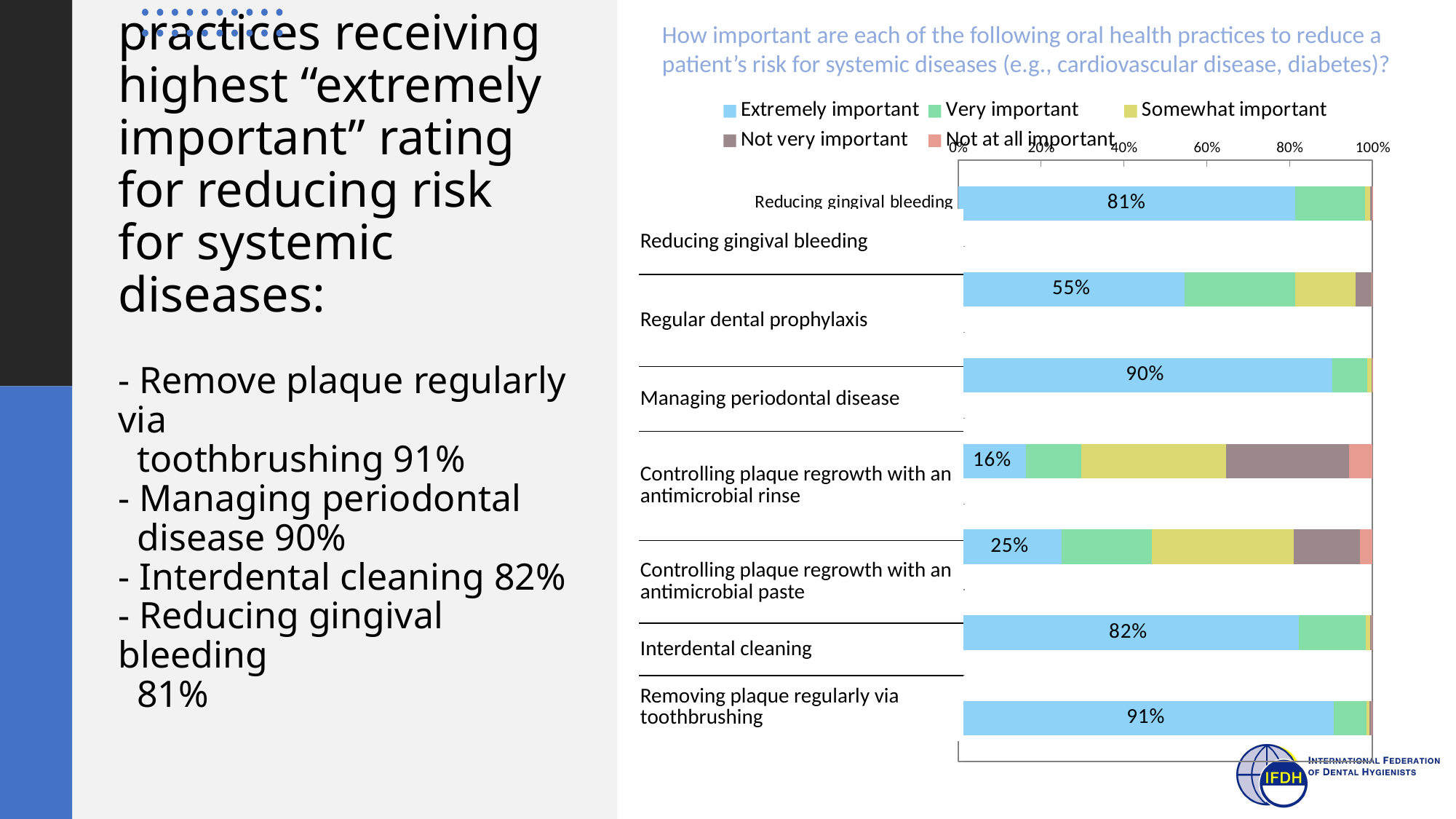
What is the 'Extremely important' value for 'Regular dental prophylaxis'? 55% What is the difference between the 'Extremely important' values for 'Interdental cleaning' and 'Regular dental prophylaxis'? 27% Which has a larger 'Extremely important' value: 'Reducing gingival bleeding' or 'Controlling plaque regrowth with an antimicrobial paste'? Reducing gingival bleeding How many oral health practices are shown in the chart? 7 How many series does the legend list? 5 What kind of chart is shown on the slide? Stacked bar chart Which practice has the highest 'Extremely important' rating? Removing plaque regularly via toothbrushing Which colour represents 'Somewhat important' in the chart? Yellow Which practice has the lowest 'Extremely important' rating? Controlling plaque regrowth with an antimicrobial rinse Is the 'Extremely important' value for 'Controlling plaque regrowth with an antimicrobial paste' greater or less than 40%? less What is the 'Extremely important' value for 'Controlling plaque regrowth with an antimicrobial rinse'? 16% What percentage of respondents rated 'Managing periodontal disease' as extremely important? 90%